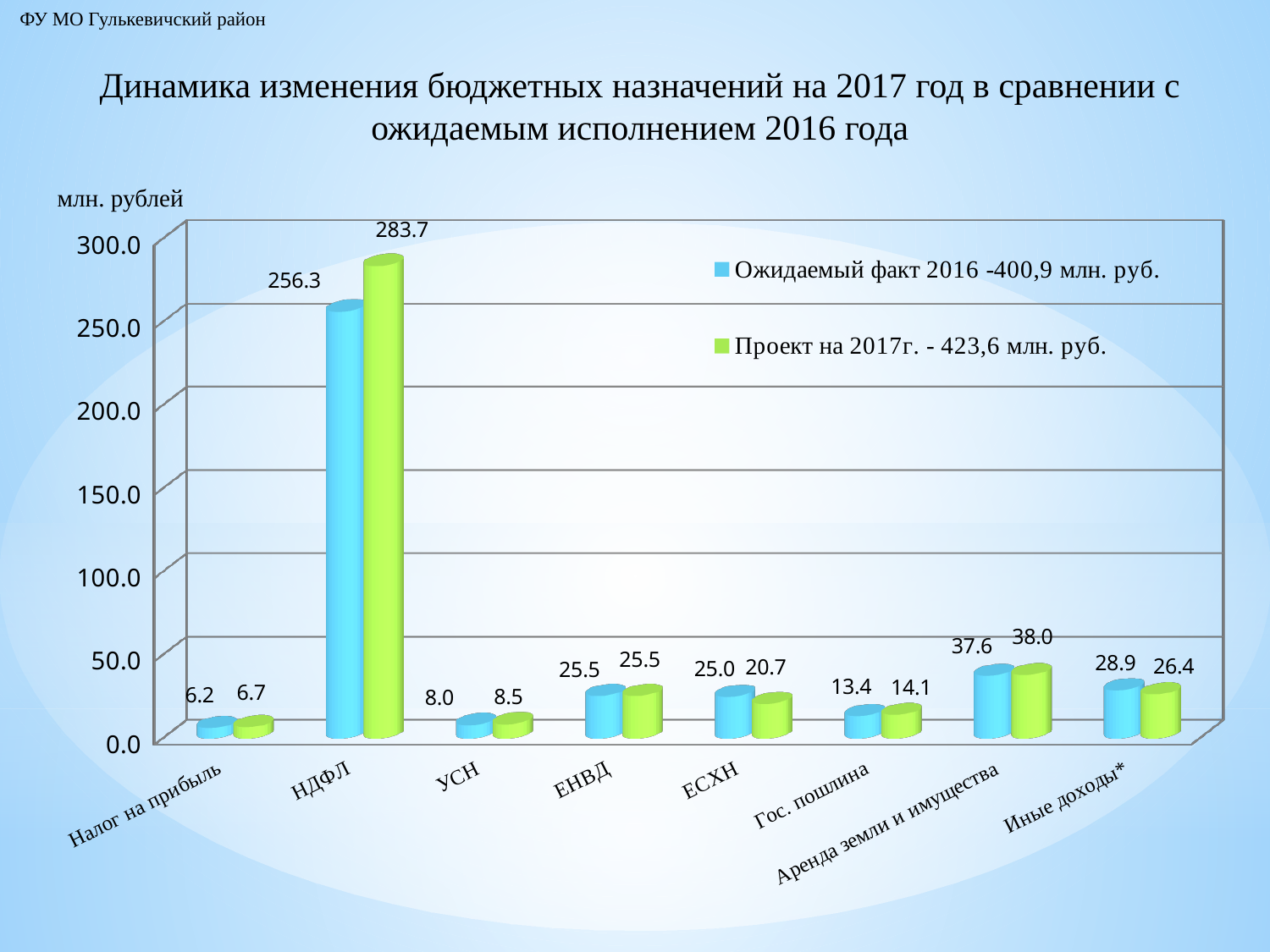
How many categories are shown on the x axis? 8 Which is larger for ЕСХН: the 'Ожидаемый факт 2016' value or the 'Проект на 2017г.' value? Ожидаемый факт 2016 What is the value for Аренда земли и имущества in the series 'Проект на 2017г. - 423,6 млн. руб.'? 38.0 Is the 'Ожидаемый факт 2016' value for НДФЛ greater or less than 250.0? greater Which category has the highest value in the series 'Ожидаемый факт 2016 -400,9 млн. руб.'? НДФЛ What is the difference between the 'Проект на 2017г.' and 'Ожидаемый факт 2016' values for НДФЛ? 27.4 What unit is shown above the vertical axis? млн. рублей Which category has the lowest value in the series 'Проект на 2017г. - 423,6 млн. руб.'? Налог на прибыль What kind of chart is shown on the slide? bar chart What is the value for НДФЛ in the series 'Проект на 2017г. - 423,6 млн. руб.'? 283.7 What is the value for Гос. пошлина in the series 'Ожидаемый факт 2016 -400,9 млн. руб.'? 13.4 How many series does the legend list? 2